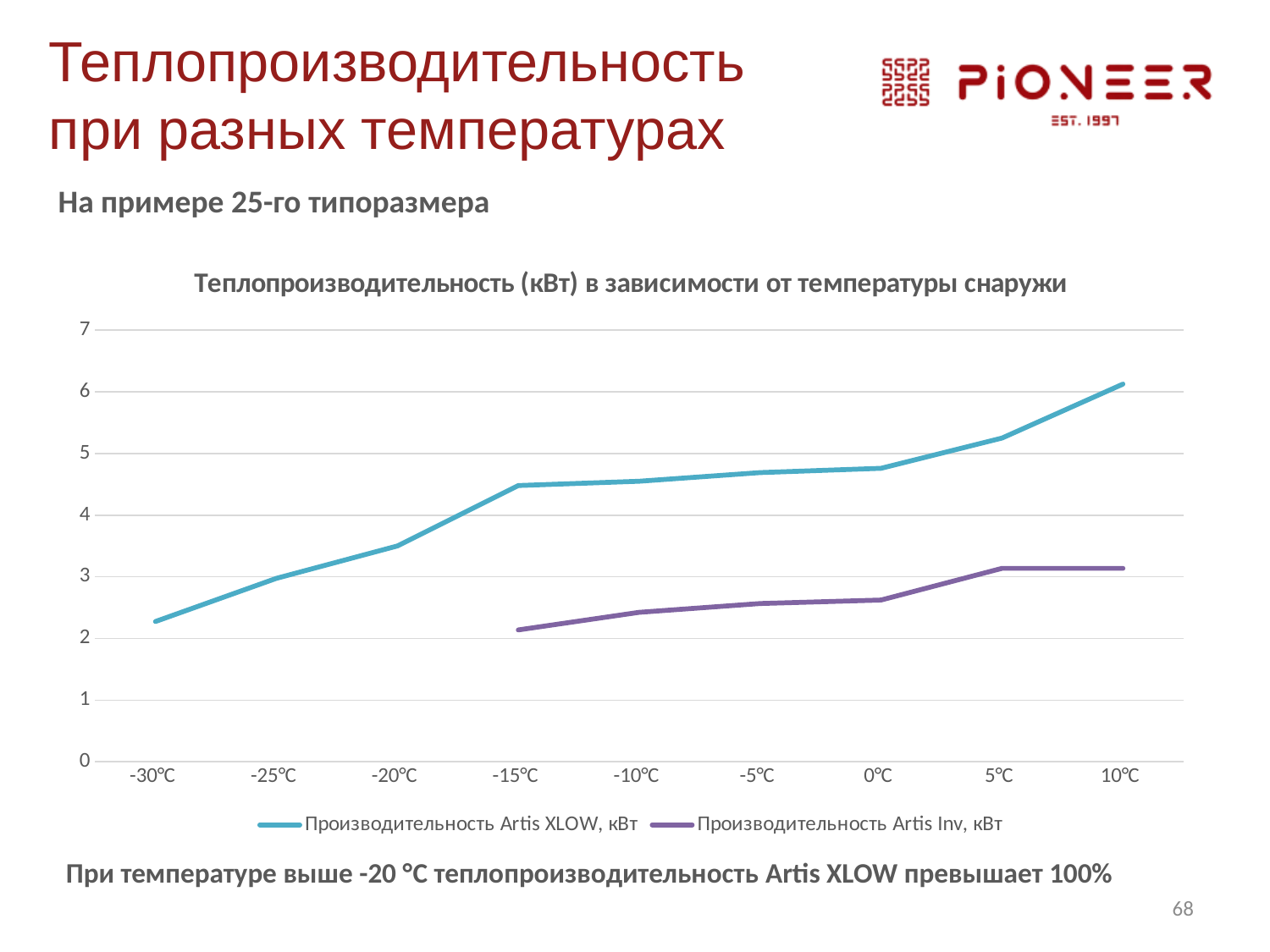
How many series does the chart legend list? 2 What kind of chart is shown on the slide? line chart Is the value for Производительность Artis Inv, кВт at 0℃ greater or less than 3? less At which temperature is the value for Производительность Artis XLOW, кВт highest? 10℃ At which temperature is the value for Производительность Artis Inv, кВт lowest? -15℃ How many temperature points are shown on the x axis? 9 Is the value for Производительность Artis XLOW, кВт at 10℃ greater or less than 5? greater Is the value for Производительность Artis XLOW, кВт at -30℃ greater or less than 3? less At 0℃, which series has the larger value: Производительность Artis XLOW, кВт or Производительность Artis Inv, кВт? Производительность Artis XLOW, кВт What is the title of the chart? Теплопроизводительность (кВт) в зависимости от температуры снаружи At which temperature is the value for Производительность Artis XLOW, кВт lowest? -30℃ Does the value for Производительность Artis XLOW, кВт generally rise or fall as the temperature increases from -30℃ to 10℃? rise